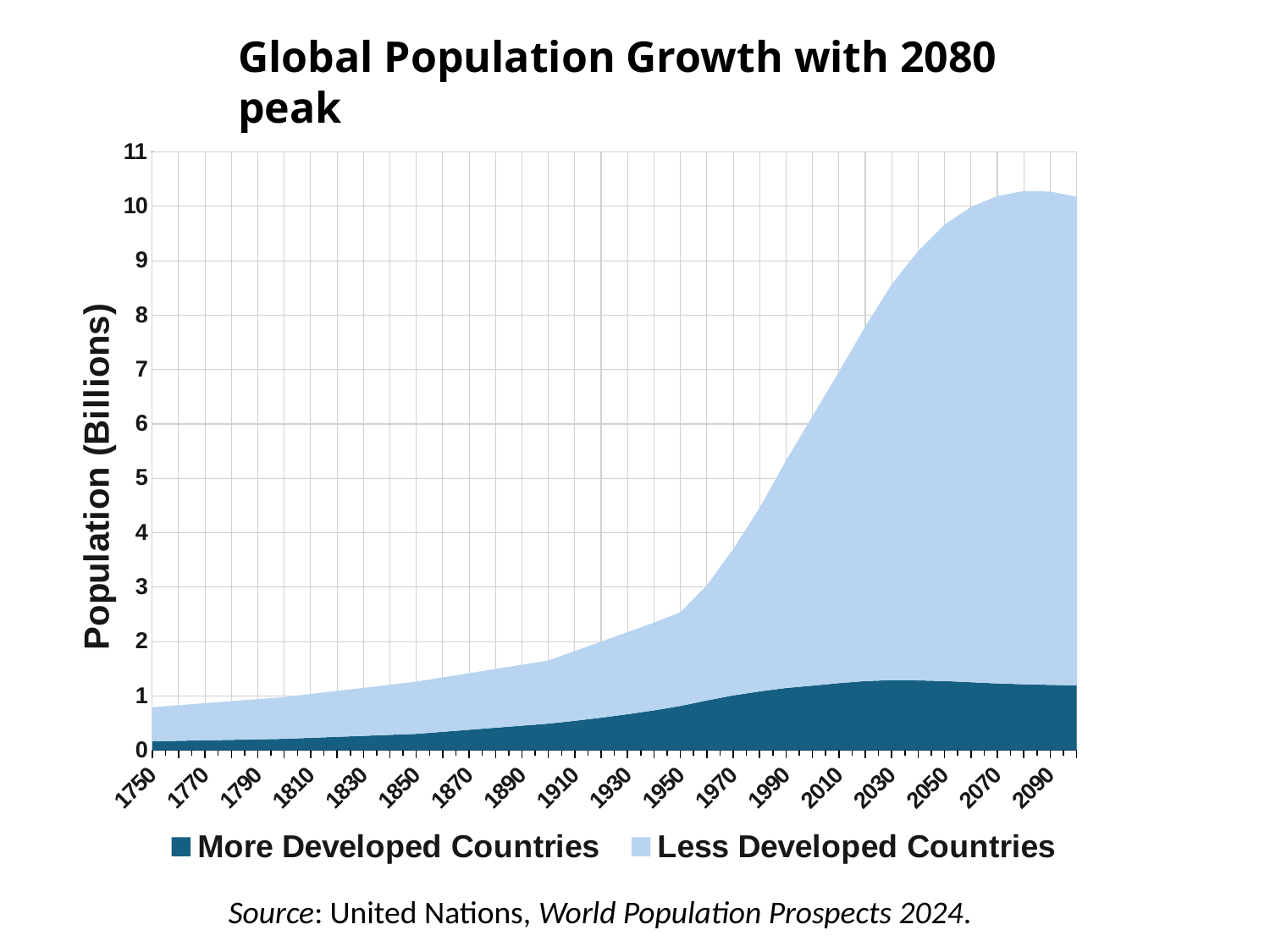
Is the total population value for 2090 greater or less than 10 billion? greater Is the total population value for 1900 greater or less than 2 billion? less Is the total population value for 1750 greater or less than 1 billion? less What is the title of the chart? Global Population Growth with 2080 peak What kind of chart is shown on the slide? Stacked area chart What is the label on the vertical axis? Population (Billions) Does the total population rise or fall between 1750 and 2050? rise How many series does the legend list? 2 Which series is larger in 2010, More Developed Countries or Less Developed Countries? Less Developed Countries